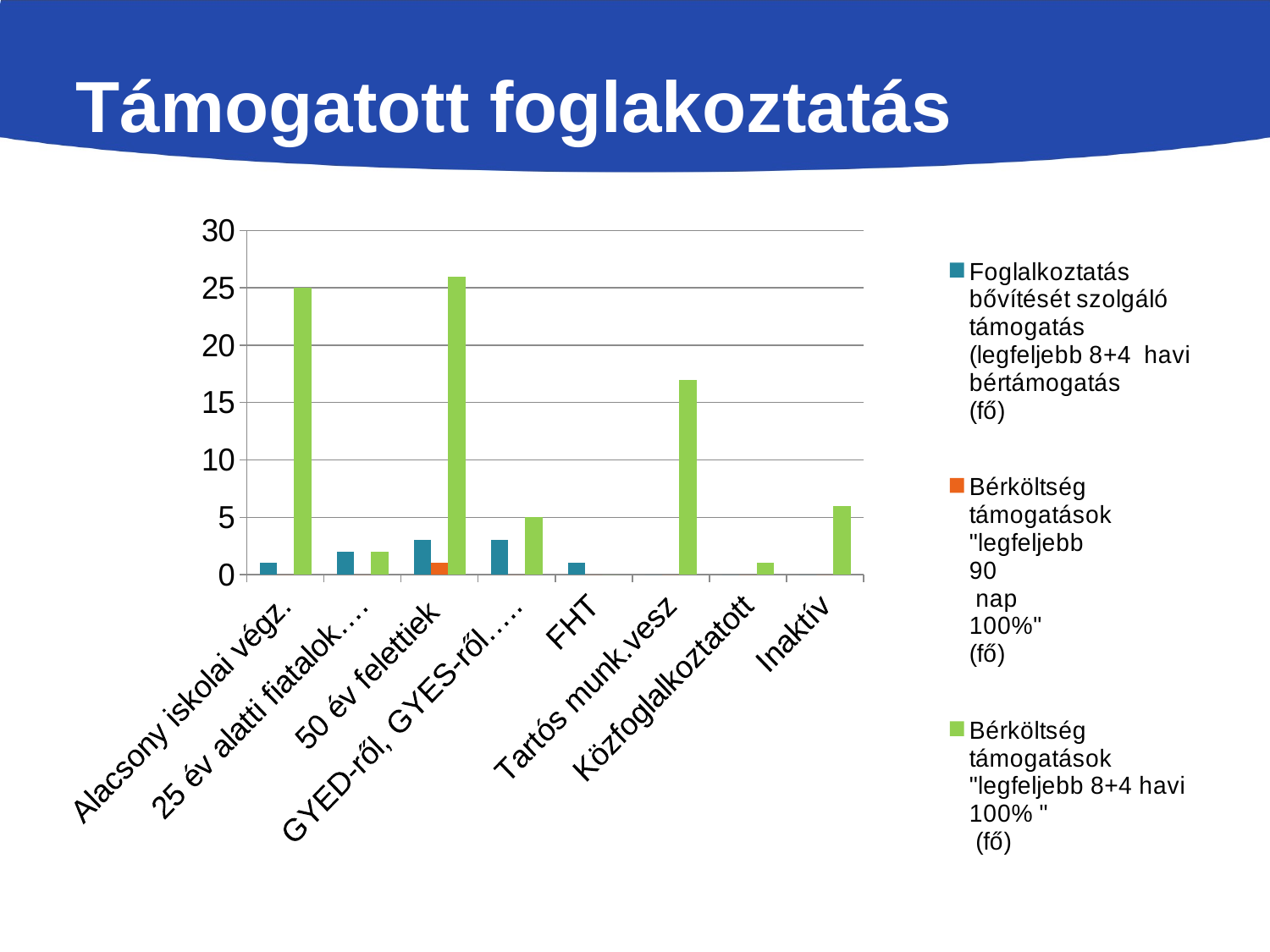
Is the value of the green series for Alacsony iskolai végz. greater or less than 20? greater What kind of chart is shown on the slide? bar chart How many series does the legend list? 3 Which is larger for the green series: the value for Tartós munk.vesz or the value for Inaktív? Tartós munk.vesz Which is larger for the green series: the value for 50 év felettiek or the value for GYED-ről, GYES-ről…? 50 év felettiek For which category does the orange series (Bérköltség támogatások "legfeljebb 90 nap 100%") show a visible bar? 50 év felettiek How many categories are shown on the x axis of the chart? 8 Is the value of the green series for Inaktív greater or less than 10? less What is the title of the slide containing the chart? Támogatott foglakoztatás Is the value of the green series for Tartós munk.vesz greater or less than 15? greater